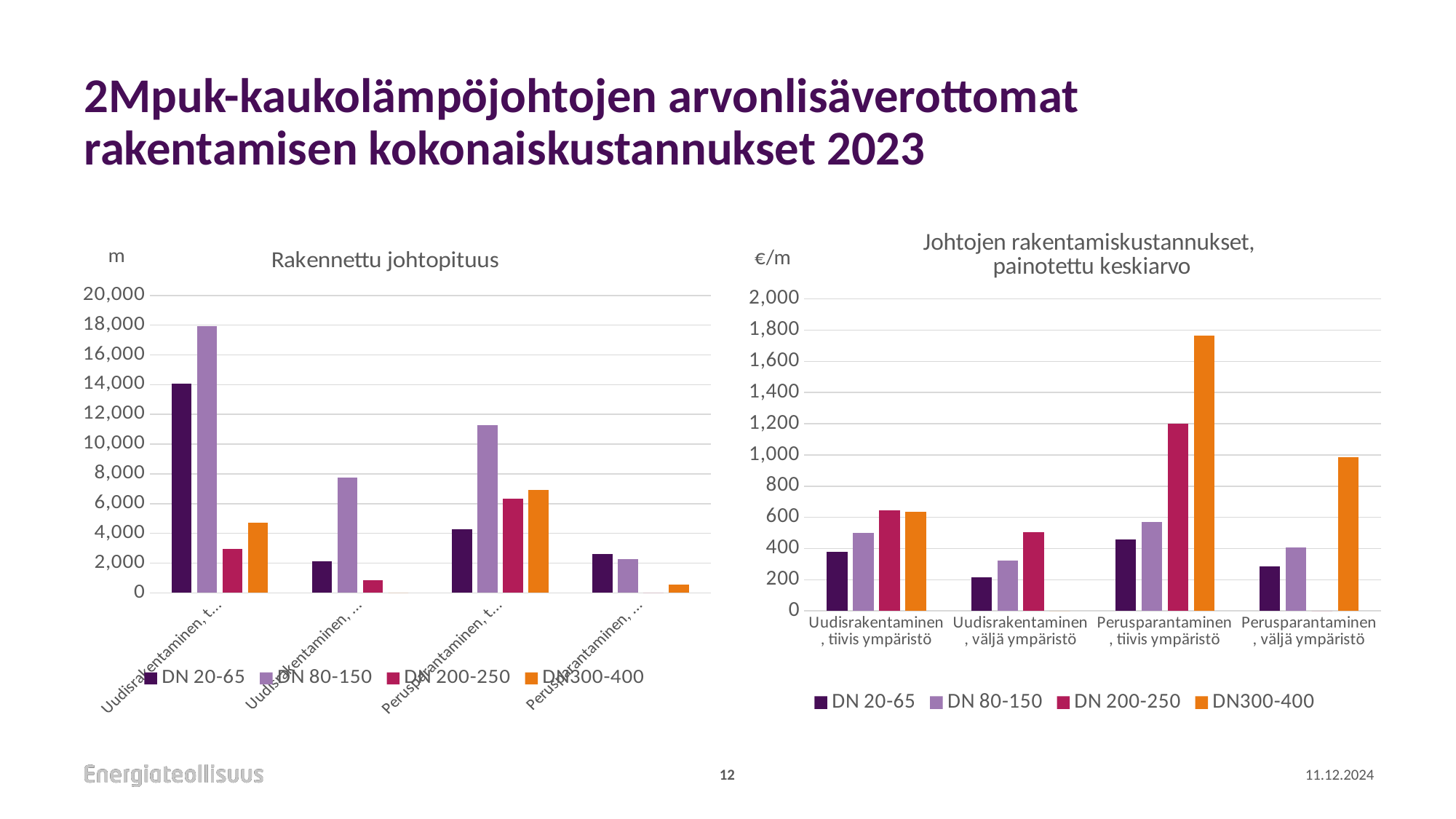
What kind of chart is the right-hand chart, 'Johtojen rakentamiskustannukset, painotettu keskiarvo'? bar chart In the right-hand chart 'Johtojen rakentamiskustannukset, painotettu keskiarvo', is the value for DN 20-65 in 'Uudisrakentaminen, väljä ympäristö' greater or less than 400? less In the right-hand chart 'Johtojen rakentamiskustannukset, painotettu keskiarvo', is the value for DN300-400 in 'Perusparantaminen, väljä ympäristö' greater or less than 800? greater How many series does the legend of the right-hand chart 'Johtojen rakentamiskustannukset, painotettu keskiarvo' list? 4 In the right-hand chart 'Johtojen rakentamiskustannukset, painotettu keskiarvo', is the value for DN300-400 in 'Perusparantaminen, tiivis ympäristö' greater or less than 1,600? greater In the right-hand chart 'Johtojen rakentamiskustannukset, painotettu keskiarvo', which series has the lowest bar in the category 'Uudisrakentaminen, tiivis ympäristö'? DN 20-65 What unit is shown on the y axis of the right-hand chart 'Johtojen rakentamiskustannukset, painotettu keskiarvo'? €/m In the right-hand chart 'Johtojen rakentamiskustannukset, painotettu keskiarvo', which series has the tallest bar in the category 'Perusparantaminen, tiivis ympäristö'? DN300-400 In the left-hand chart 'Rakennettu johtopituus', which series has the tallest bar overall? DN 80-150 How many categories are shown on the x axis of the right-hand chart 'Johtojen rakentamiskustannukset, painotettu keskiarvo'? 4 In the right-hand chart 'Johtojen rakentamiskustannukset, painotettu keskiarvo', which is larger for 'Perusparantaminen, tiivis ympäristö': DN 200-250 or DN 80-150? DN 200-250